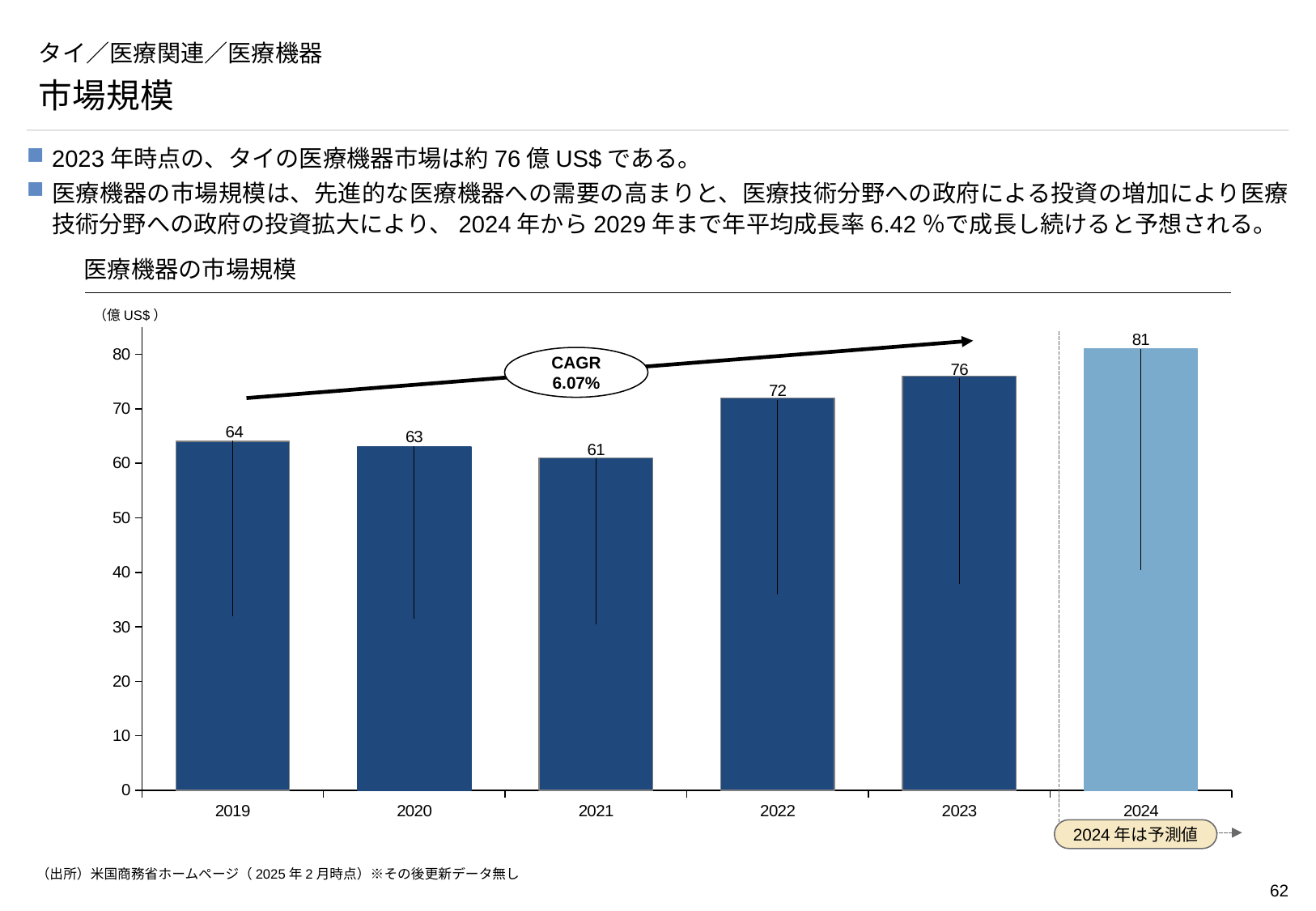
Which year has the highest value? 2024 What is the value for 2021? 61 Which is larger, the value for 2020 or the value for 2022? 2022 Do the values rise or fall from 2021 to 2024? rise How many years are shown on the x axis? 6 What is the value for 2019? 64 What is the forecast value for 2024? 81 What CAGR is shown in the oval on the chart? 6.07% What kind of chart is this? bar chart What is the value for 2023? 76 Which year has the lowest value? 2021 What is the difference between the values for 2023 and 2019? 12